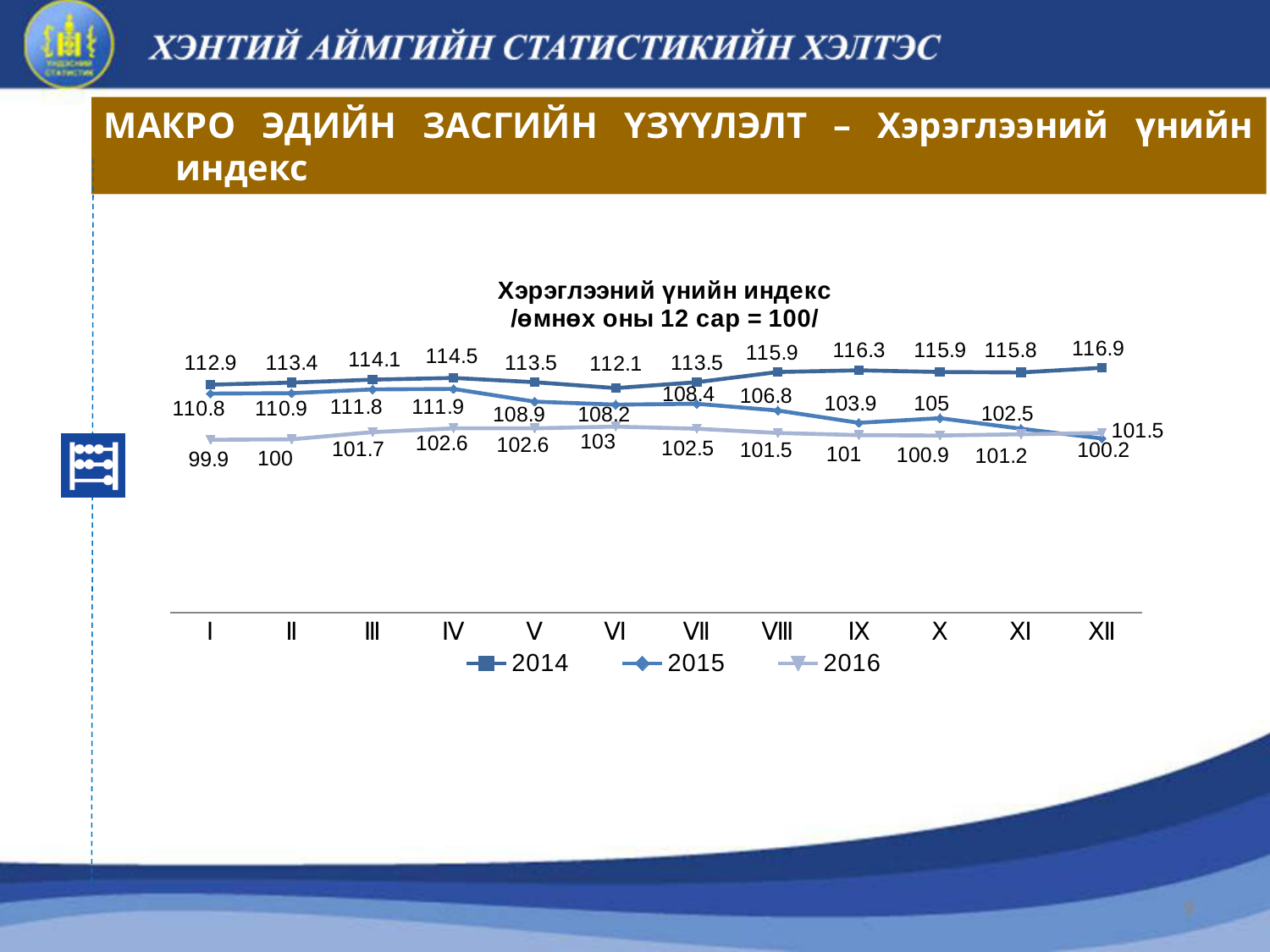
What kind of chart is shown on the slide? line chart What is the value for 2014 in month XII? 116.9 In which month is the 2015 series lowest? XII Which is larger in month IV: the 2015 value or the 2016 value? 2015 In which month is the 2014 series highest? XII What is the value for 2016 in month I? 99.9 What is the value for 2015 in month VIII? 106.8 How many months (categories) are shown on the x axis? 12 Does the 2015 series generally rise or fall from month I to month XII? fall In which month is the 2016 series highest? VI What is the difference between the 2014 and 2015 values in month IX? 12.4 How many series does the legend list? 3